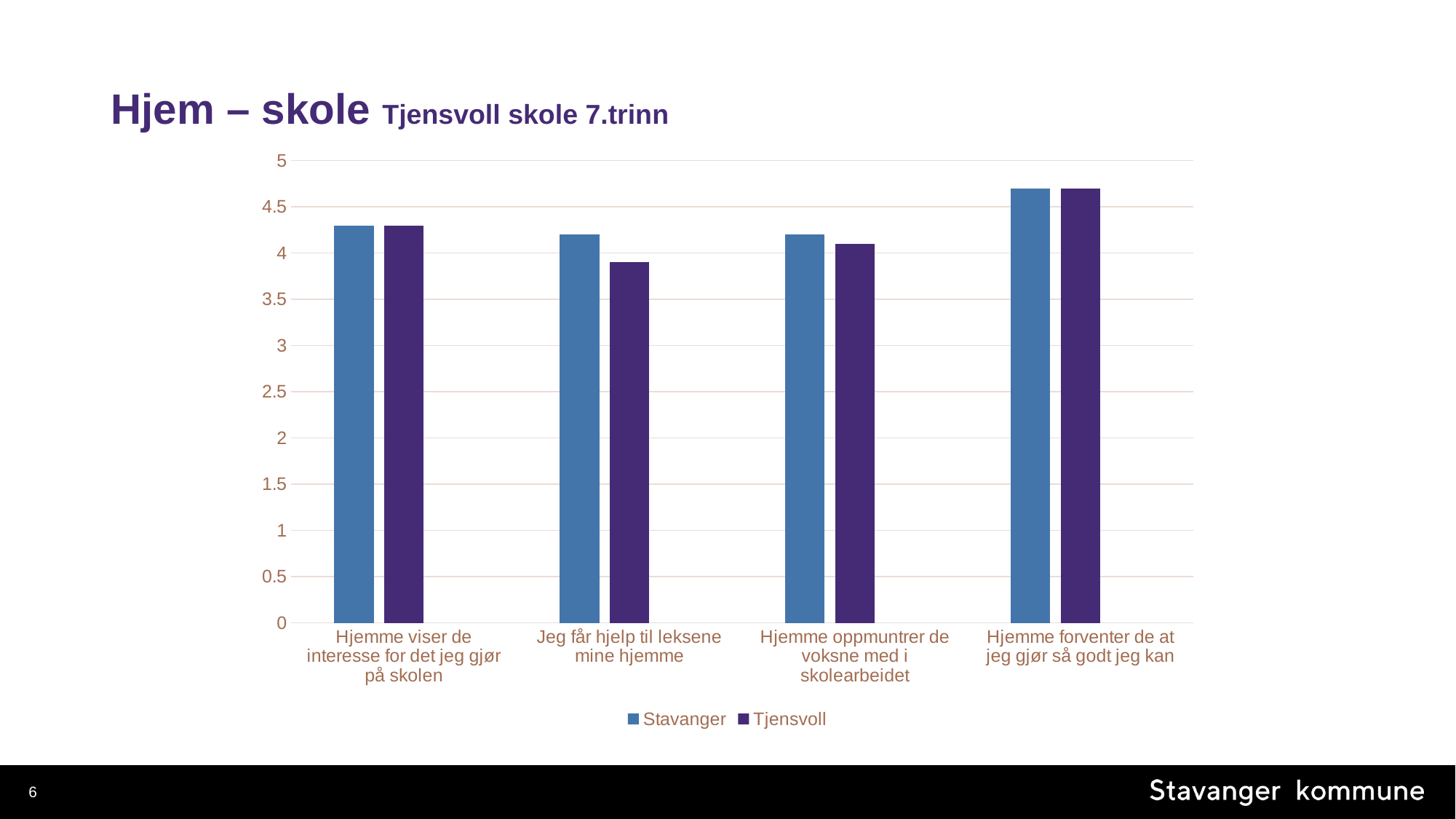
Is the Tjensvoll value for 'Jeg får hjelp til leksene mine hjemme' greater or less than 4? less For which category is the Tjensvoll value highest? Hjemme forventer de at jeg gjør så godt jeg kan What kind of chart is shown on the slide? bar chart What is the title of the chart? Hjem – skole Tjensvoll skole 7.trinn For which category is the Tjensvoll value lowest? Jeg får hjelp til leksene mine hjemme How many series does the legend list? 2 For which category is the Stavanger value highest? Hjemme forventer de at jeg gjør så godt jeg kan For 'Jeg får hjelp til leksene mine hjemme', which is larger, the Stavanger value or the Tjensvoll value? Stavanger Is the Stavanger value for 'Hjemme forventer de at jeg gjør så godt jeg kan' greater or less than 4.5? greater How many categories are shown on the x axis of the chart? 4 Which series are listed in the legend? Stavanger and Tjensvoll Is the Tjensvoll value for 'Hjemme viser de interesse for det jeg gjør på skolen' greater or less than 4? greater